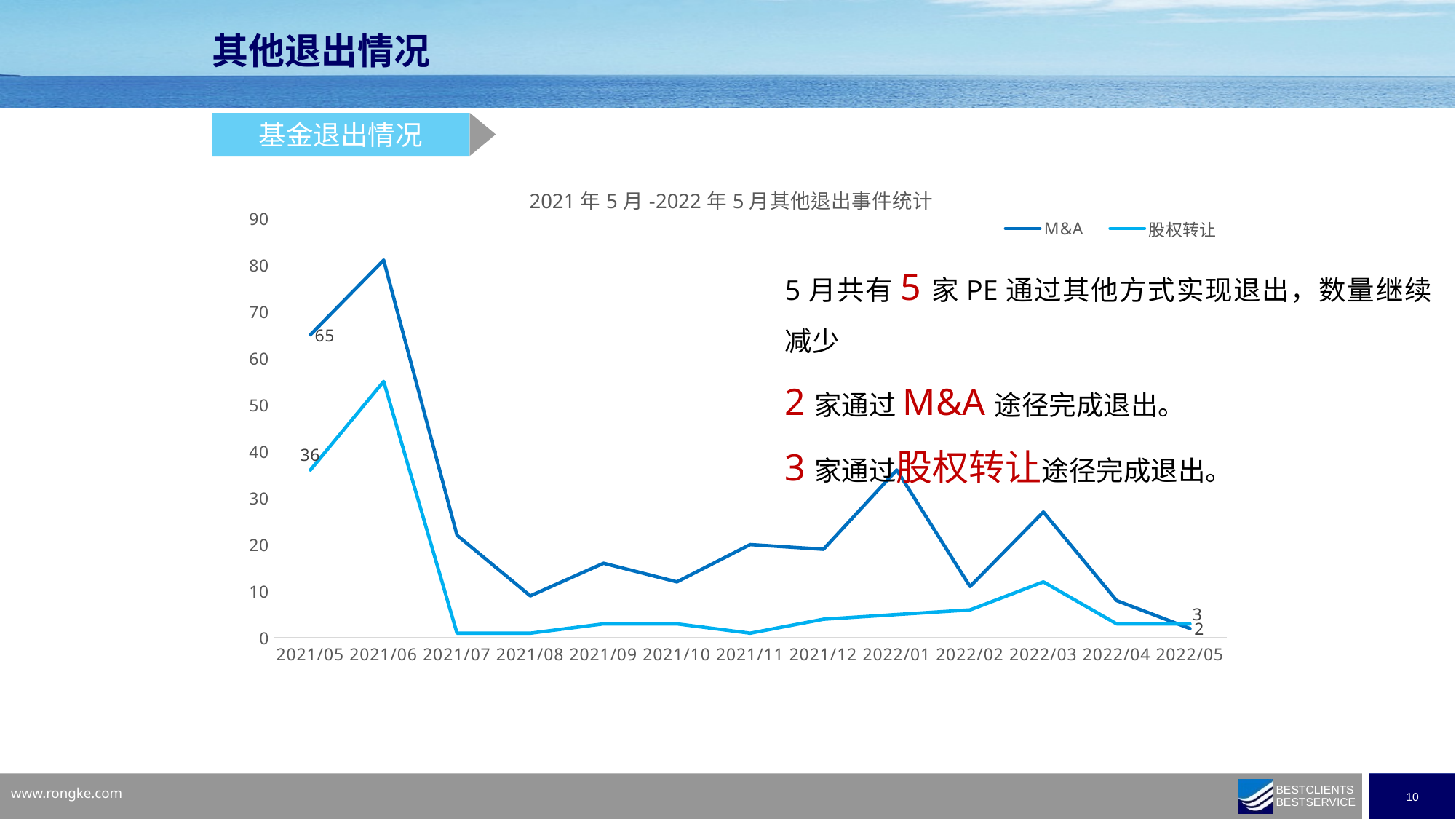
What is the 股权转让 value for 2022/05? 3 In 2021/05, which series has the larger value, M&A or 股权转让? M&A In which month does the M&A series reach its highest value? 2021/06 How many months are shown on the x axis? 13 Is the 股权转让 value for 2021/06 greater or less than 50? greater What is the 股权转让 value for 2021/05? 36 How many series does the legend list? 2 What is the difference between the M&A and 股权转让 values in 2021/05? 29 What is the M&A value for 2022/05? 2 What is the M&A value for 2021/05? 65 What type of chart is shown on the slide? Line chart Is the M&A value for 2021/06 greater or less than 70? greater